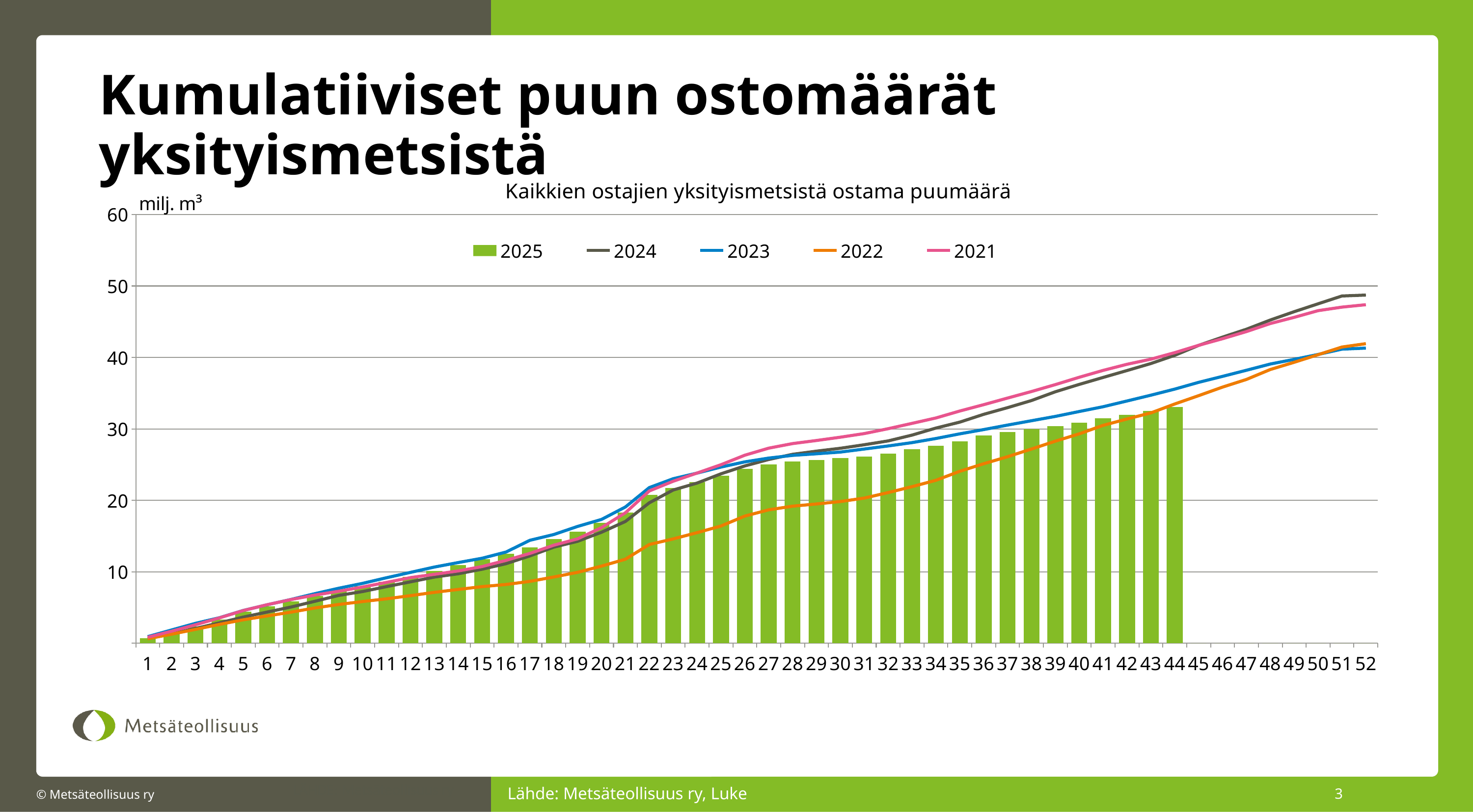
Is the 2021 value at week 52 greater or less than 40? greater How many series does the legend list? 5 Which series is drawn as bars rather than a line? 2025 What kind of chart is shown on the slide? A combined bar and line chart Up to which week do the 2025 bars extend? 44 What is the unit shown on the vertical axis? milj. m³ Is the 2024 value at week 52 greater or less than 50? less At week 30, which series has the lowest value? 2022 Is the 2025 value at week 44 greater or less than 30? greater Do the cumulative values rise or fall along the x axis for each series? Rise At week 52, which is higher: the 2024 line or the 2022 line? 2024